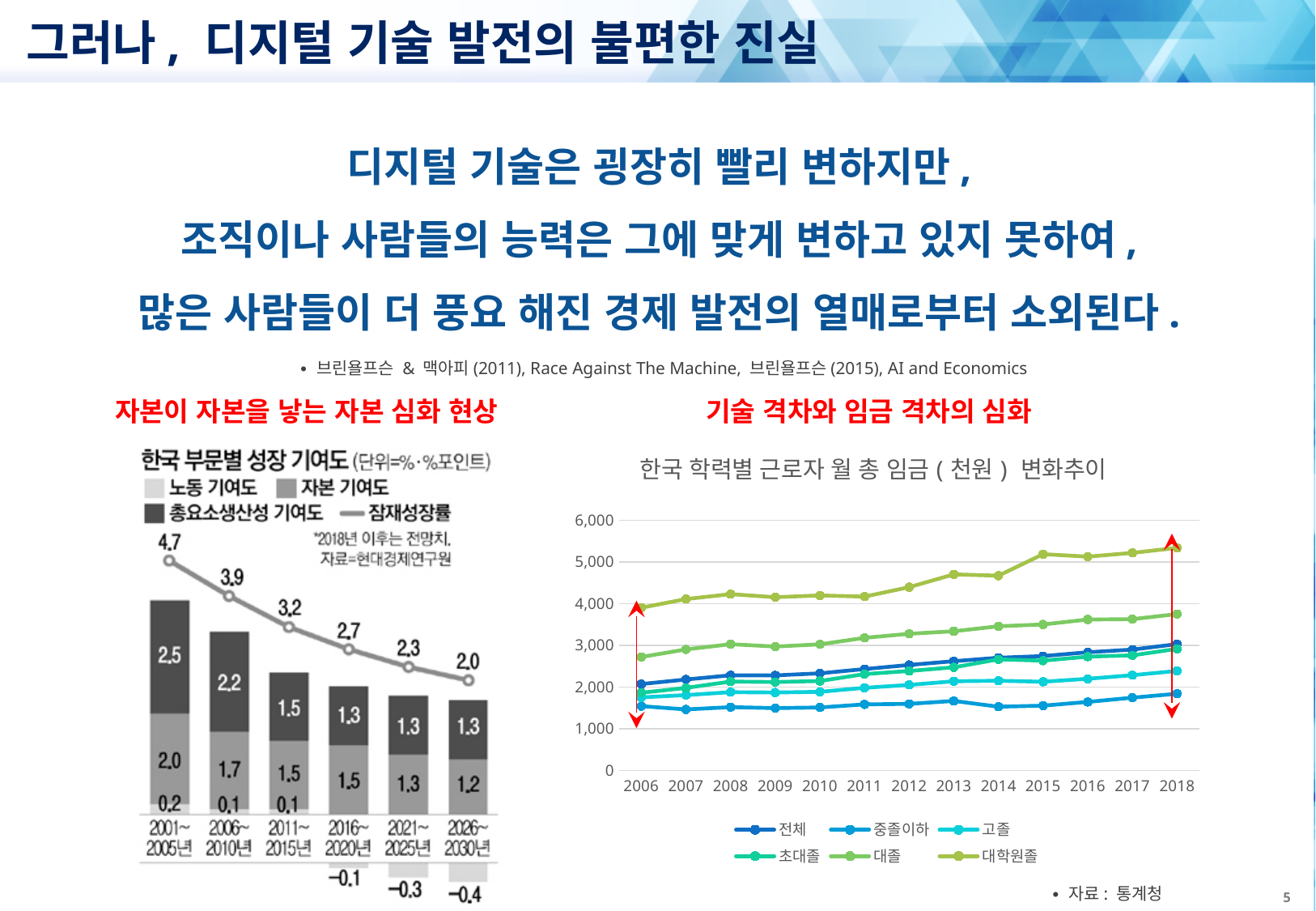
In the right-hand chart (한국 학력별 근로자 월 총 임금 변화추이), which education group has the lowest wage in 2018? 중졸이하 In the right-hand chart (한국 학력별 근로자 월 총 임금 변화추이), how many years are shown on the x axis? 13 In the right-hand chart (한국 학력별 근로자 월 총 임금 변화추이), is the 2018 value for 대학원졸 greater or less than 5,000? greater In the right-hand chart (한국 학력별 근로자 월 총 임금 변화추이), which education group has the highest wage in 2018? 대학원졸 In the right-hand chart (한국 학력별 근로자 월 총 임금 변화추이), how many series does the legend list? 6 In the right-hand chart (한국 학력별 근로자 월 총 임금 변화추이), does the 대학원졸 line generally rise or fall from 2006 to 2018? Rise In the left-hand chart (한국 부문별 성장 기여도), what is the difference between the 잠재성장률 for 2001~2005년 and 2026~2030년? 2.7 In the left-hand chart (한국 부문별 성장 기여도), what is the 노동 기여도 value for 2026~2030년? -0.4 In the right-hand chart (한국 학력별 근로자 월 총 임금 변화추이), is the 2006 value for 대졸 greater or less than 3,000? less In the left-hand chart (한국 부문별 성장 기여도), what is the 잠재성장률 value for 2001~2005년? 4.7 In the left-hand chart (한국 부문별 성장 기여도), does the 잠재성장률 line rise or fall across the periods? Fall What kind of chart is the right-hand chart titled 한국 학력별 근로자 월 총 임금 (천원) 변화추이? Line chart